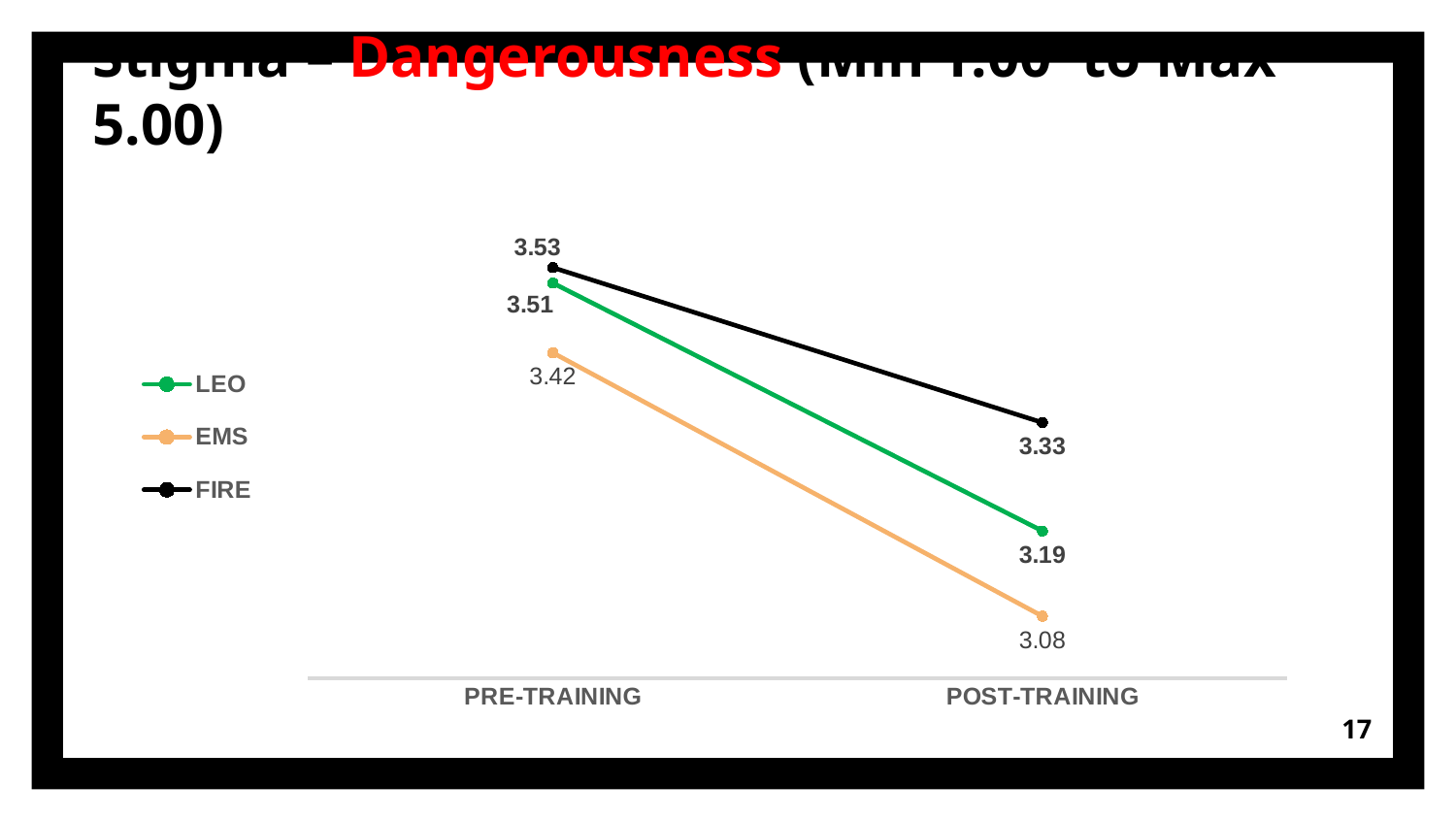
Which series has the highest value at POST-TRAINING? FIRE What is the difference between the FIRE and EMS values at POST-TRAINING? 0.25 Which is larger at POST-TRAINING, the LEO value or the EMS value? LEO Which series has the lowest value at PRE-TRAINING? EMS What kind of chart is shown on the slide? Line chart Do the values for EMS rise or fall from PRE-TRAINING to POST-TRAINING? Fall What is the value for FIRE at POST-TRAINING? 3.33 What is the value for LEO at PRE-TRAINING? 3.51 What is the difference between the LEO values at PRE-TRAINING and POST-TRAINING? 0.32 How many series does the legend list? 3 What is the value for EMS at PRE-TRAINING? 3.42 What is the value for EMS at POST-TRAINING? 3.08